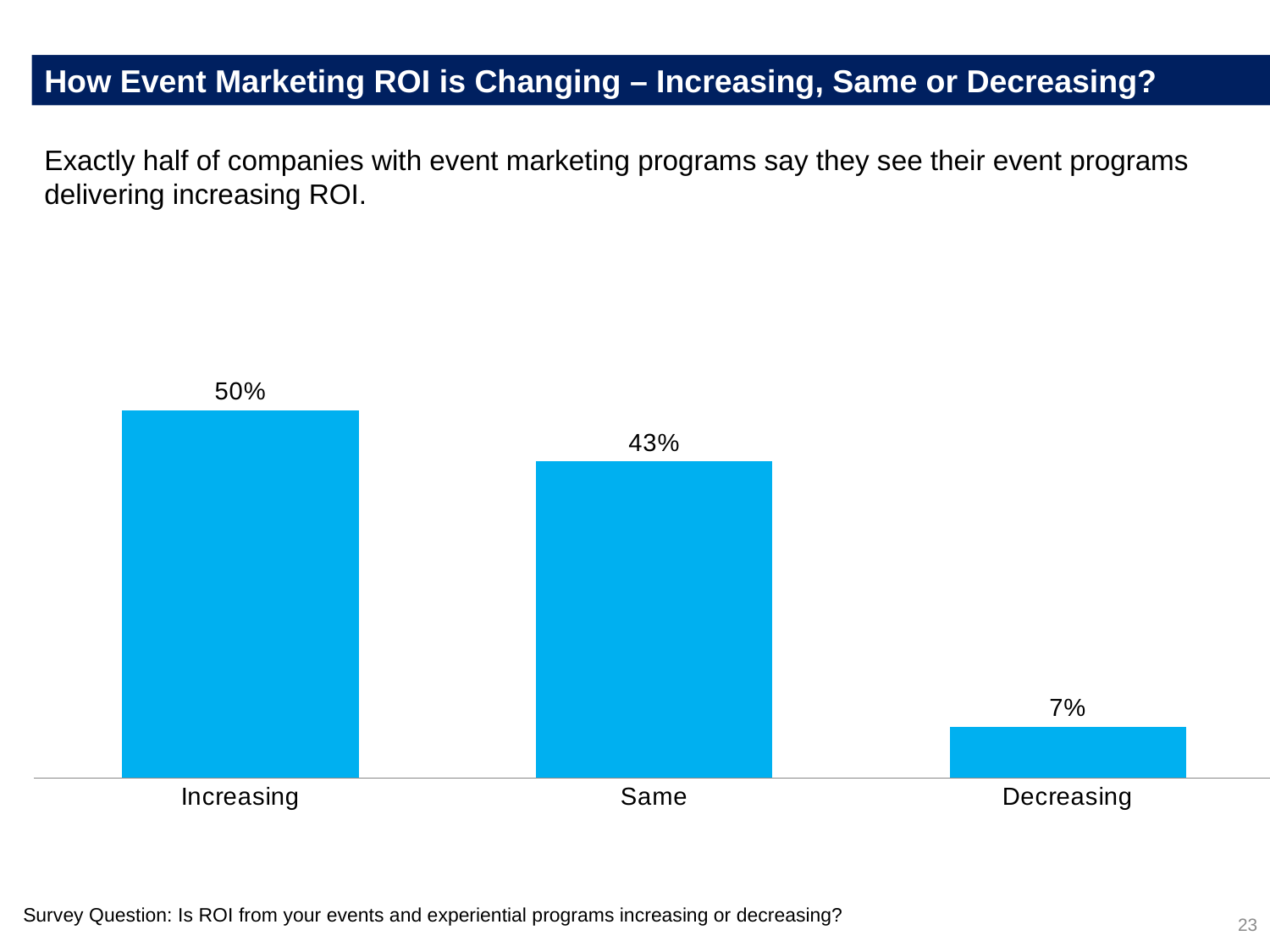
What percentage of companies say their event marketing ROI is Decreasing? 7% How many categories are shown in the chart? 3 Which category has the highest value in the chart? Increasing What kind of chart is shown on the slide? Bar chart What percentage of companies say their event marketing ROI is the Same? 43% Which is larger, the value for Same or the value for Decreasing? Same What colour are the bars in the chart? Blue Which category has the lowest value in the chart? Decreasing What is the difference in percentage points between Same and Decreasing? 36 Do the values rise or fall moving from left to right across the categories? Fall What percentage of companies say their event marketing ROI is Increasing? 50% What is the difference in percentage points between Increasing and Same? 7